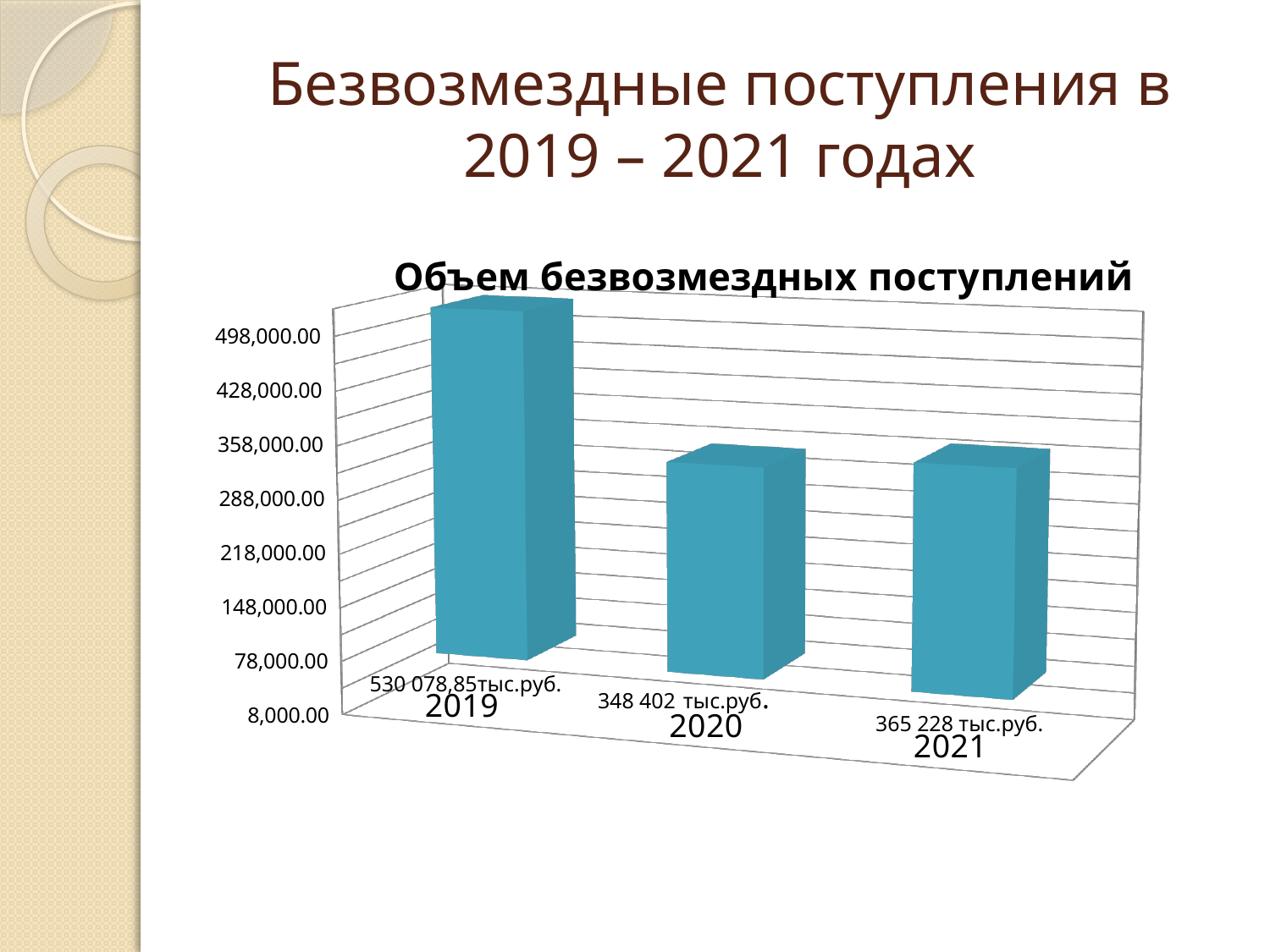
What is the value shown for 2020? 348 402 тыс.руб. Which year has the highest volume of gratuitous receipts? 2019 What is the value shown for 2021? 365 228 тыс.руб. What kind of chart is shown on the slide? bar chart What is the title of the chart? Объем безвозмездных поступлений What is the value shown for 2019? 530 078,85 тыс.руб. Is the value for 2019 greater or less than 428,000.00? greater How many years are shown on the chart? 3 By how much does the value for 2021 exceed the value for 2020? 16 826 тыс.руб. Is the value for 2020 greater or less than 288,000.00? greater Which year has the lowest volume of gratuitous receipts? 2020 Which is larger, the value for 2019 or the value for 2020? 2019